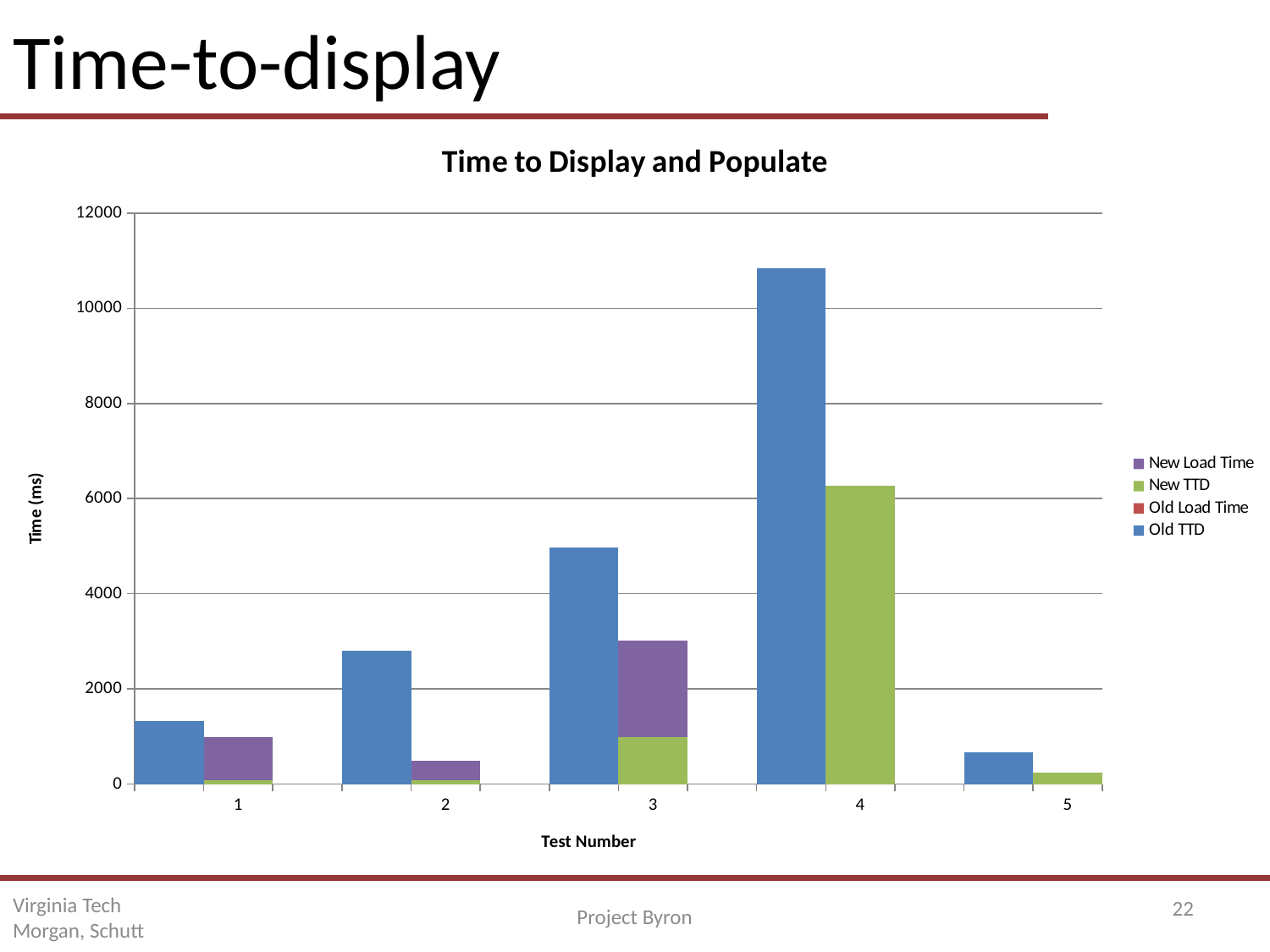
Is the Old TTD value for test 5 greater or less than 1000? less For which test number is the Old TTD value lowest? 5 Is the New TTD value for test 4 greater or less than 6000? greater What kind of chart is shown on the slide? bar chart How many series does the legend list? 4 For which test number is the Old TTD value highest? 4 Is the Old TTD value for test 4 greater or less than 10000? greater Do the Old TTD values rise or fall from test 1 to test 4? rise How many test numbers are shown on the x axis? 5 What is the title of the chart? Time to Display and Populate For test 4, which is larger: the Old TTD value or the New TTD value? Old TTD